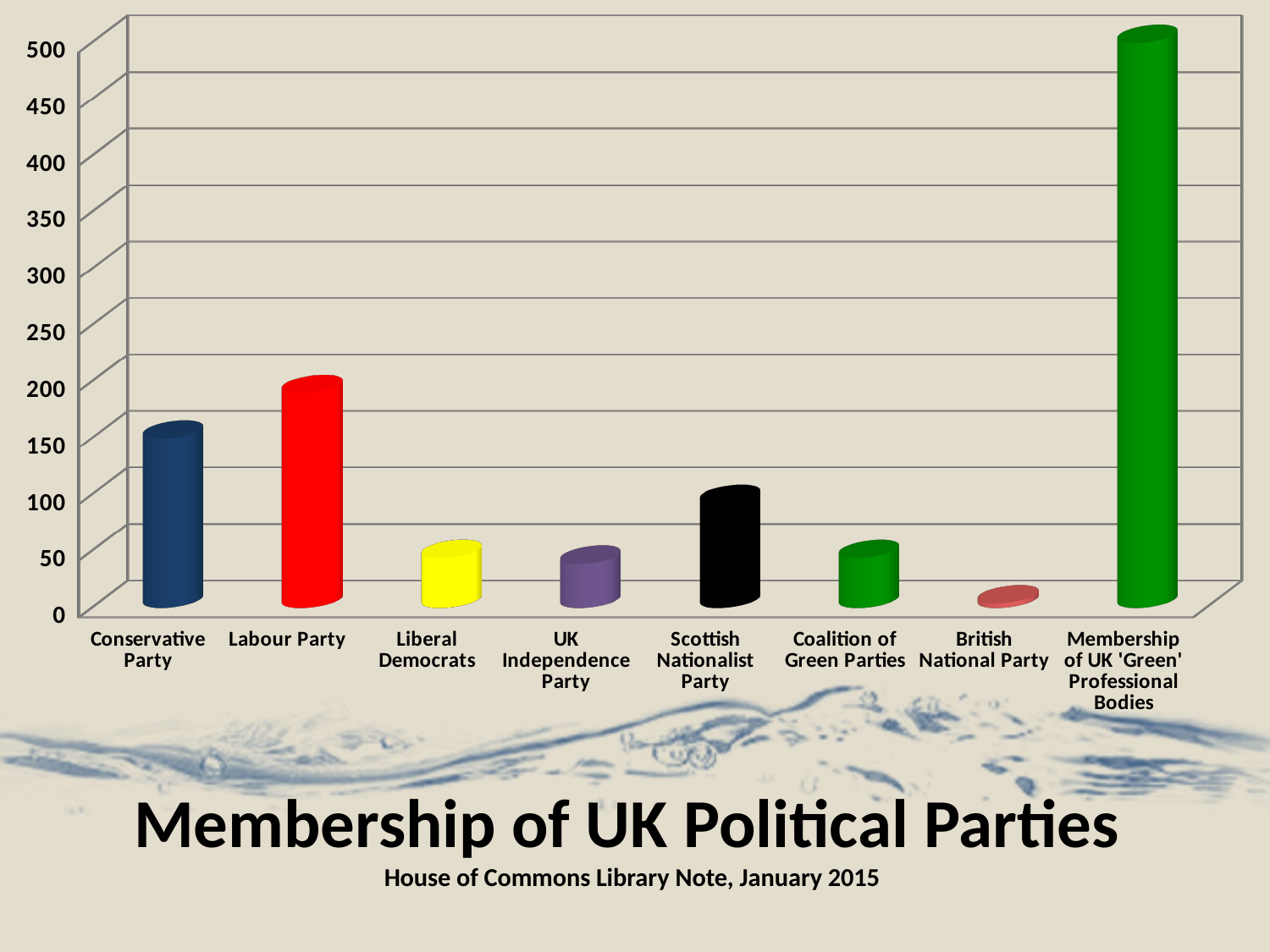
What kind of chart is shown on the slide? Bar chart Which category has the highest bar? Membership of UK 'Green' Professional Bodies What is the title of the chart on the slide? Membership of UK Political Parties Which category has the lowest bar? British National Party Which is larger, the value for the Scottish Nationalist Party or the Coalition of Green Parties? Scottish Nationalist Party How many categories are plotted in the chart? 8 Is the value for Membership of UK 'Green' Professional Bodies greater or less than 400? greater Which is larger, the value for the Labour Party or the Conservative Party? Labour Party Is the value for the British National Party greater or less than 50? less Which political party has the highest membership among the political parties shown (excluding the Green Professional Bodies bar)? Labour Party Is the value for the Conservative Party greater or less than 100? greater